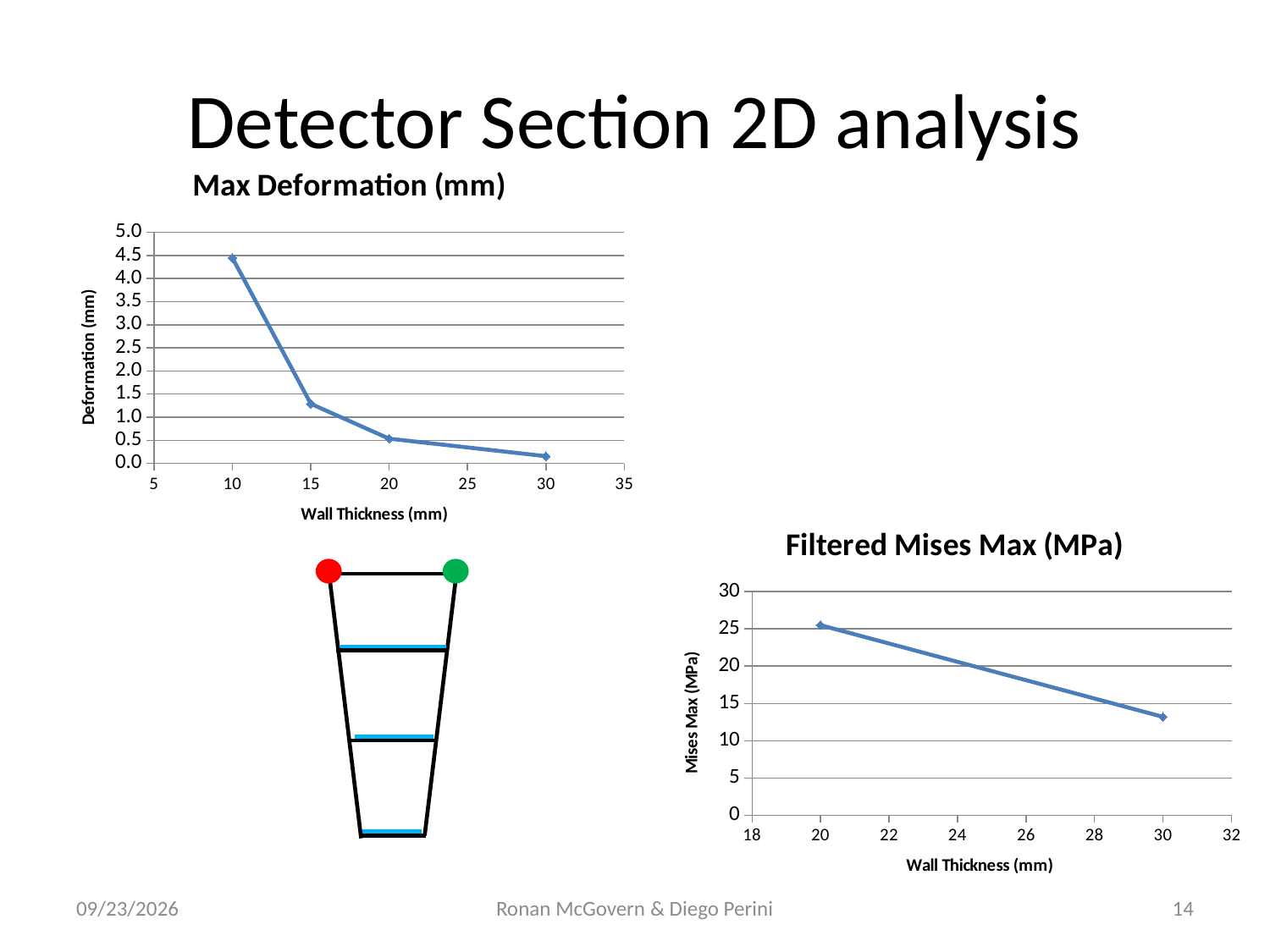
On the "Filtered Mises Max (MPa)" chart, is the value at a wall thickness of 30 mm greater or less than 15? less How many data points are plotted on the "Max Deformation (mm)" chart? 4 What is the label of the x axis on the "Filtered Mises Max (MPa)" chart? Wall Thickness (mm) How many data points are plotted on the "Filtered Mises Max (MPa)" chart? 2 On the "Max Deformation (mm)" chart, is the deformation at a wall thickness of 10 mm greater or less than 4.0? greater On the "Max Deformation (mm)" chart, is the deformation at a wall thickness of 15 mm greater or less than 1.5? less What kind of chart is the "Filtered Mises Max (MPa)" chart? line chart On the "Max Deformation (mm)" chart, do the values rise or fall as wall thickness increases? fall On the "Max Deformation (mm)" chart, which wall thickness has the highest deformation? 10 What kind of chart is the "Max Deformation (mm)" chart? line chart On the "Filtered Mises Max (MPa)" chart, do the values rise or fall as wall thickness increases? fall